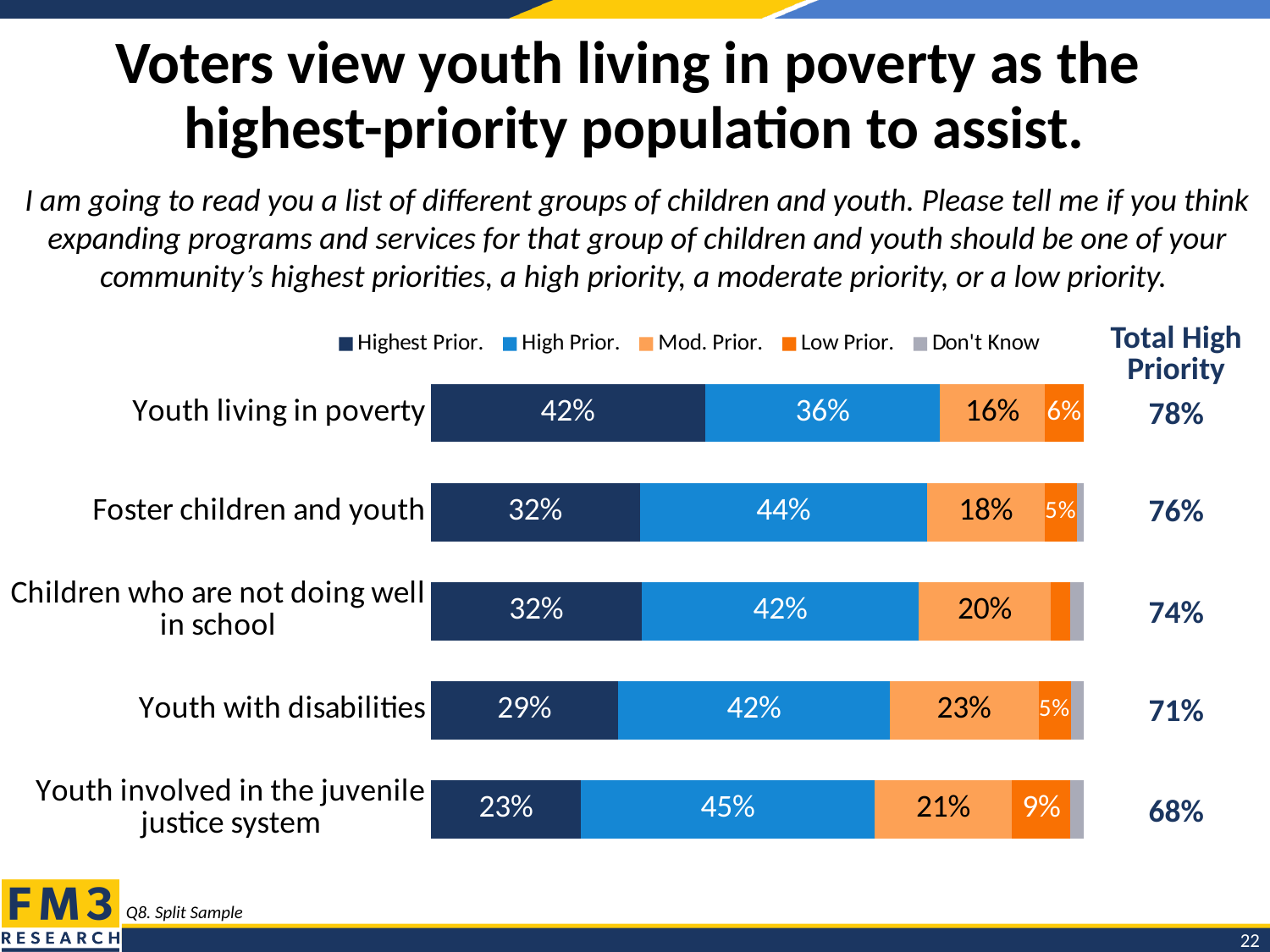
What is the Highest Prior. value for Youth living in poverty? 42% What is the Total High Priority figure shown for Children who are not doing well in school? 74% What is the difference between the Highest Prior. values for Youth living in poverty and Foster children and youth? 10% What is the High Prior. value for Youth involved in the juvenile justice system? 45% What is the Mod. Prior. value for Youth with disabilities? 23% How many series does the legend list? 5 Which is larger: the High Prior. value for Foster children and youth or for Youth living in poverty? Foster children and youth What kind of chart is shown on the slide? Stacked bar chart How many groups of children and youth are plotted in the chart? 5 Which group has the lowest Highest Prior. value? Youth involved in the juvenile justice system Which group has the highest Highest Prior. value? Youth living in poverty What is the Low Prior. value for Youth involved in the juvenile justice system? 9%